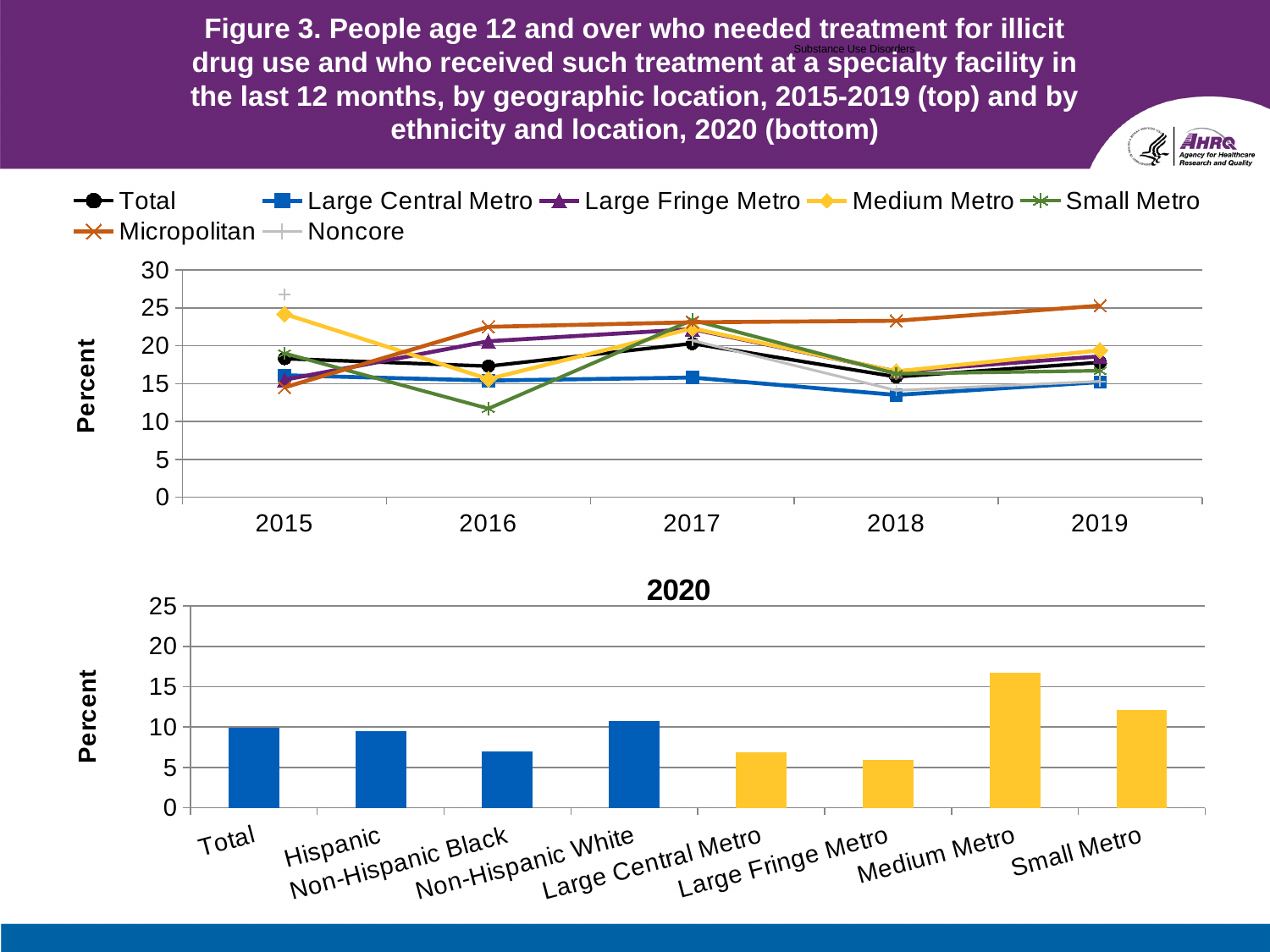
How many years are plotted on the x axis of the top chart? 5 In the bottom chart (2020), which is larger, Medium Metro or Small Metro? Medium Metro What kind of chart is the bottom chart (2020)? bar chart In the top chart, which series has the lowest value in 2016? Small Metro In the top chart, which series has the highest value in 2019? Micropolitan How many categories are shown on the bottom chart (2020)? 8 In the bottom chart (2020), which category has the highest value? Medium Metro In the top chart, does the Micropolitan series rise or fall from 2015 to 2019? rise In the bottom chart (2020), is the value for Medium Metro greater or less than 15? greater In the top chart, is the value for Micropolitan in 2019 greater or less than 20? greater How many series does the legend of the top chart list? 7 What kind of chart is the top chart (2015-2019)? line chart